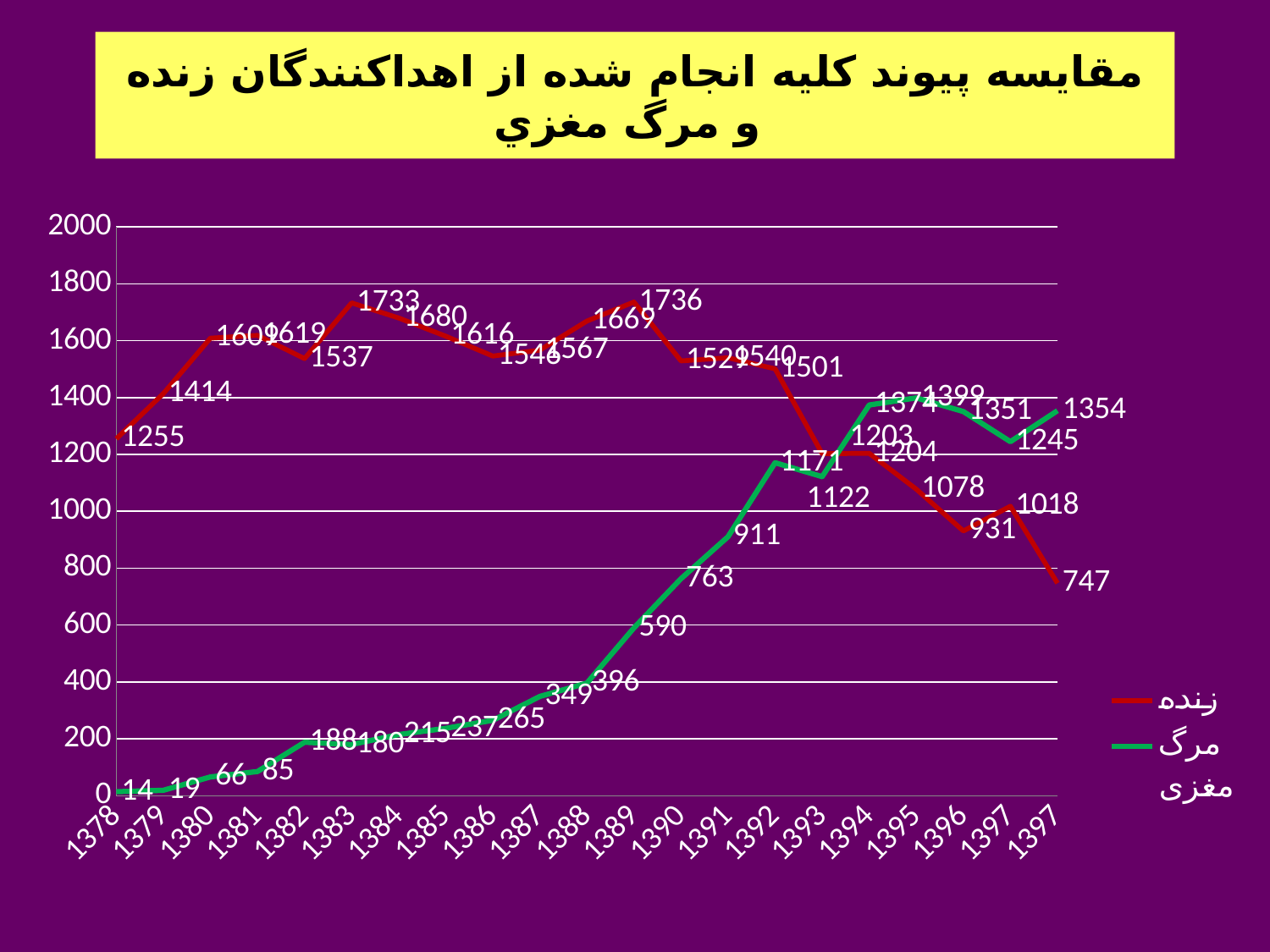
Does the مرگ مغزی series generally rise or fall from 1378 to 1395? rise What is the difference between the مرگ مغزی values for 1390 and 1389? 173 What is the value of the زنده series for 1392? 1501 What is the lowest value of the مرگ مغزی series? 14 Is the value of the مرگ مغزی series for 1391 greater or less than 800? greater What is the value of the مرگ مغزی series for 1390? 763 What is the difference between the زنده values for 1383 and 1384? 53 What is the value of the زنده series for 1378? 1255 How many series does the legend list? 2 In 1396, which series has the larger value, زنده or مرگ مغزی? مرگ مغزی What kind of chart is shown on the slide? line chart What is the highest value reached by the زنده series, and in which year? 1736 in 1389